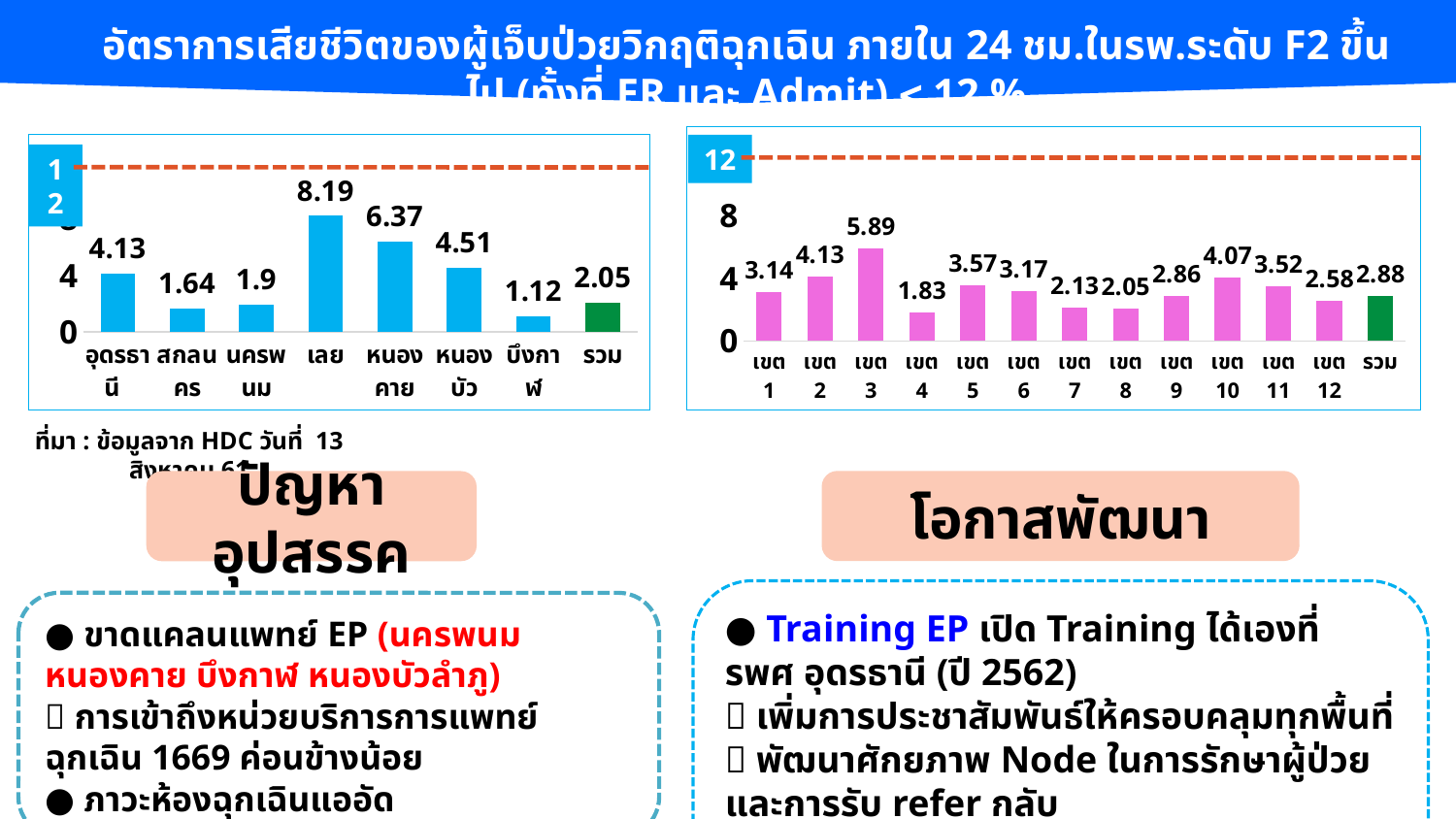
In the right chart, which เขต has the lowest value? เขต 4 In the left chart, what is the difference between the values for เลย and หนองคาย? 1.82 In the right chart, what is the value for เขต 3? 5.89 In the left chart, which category has the lowest value? บึงกาฬ In the right chart, which เขต has the highest value? เขต 3 In the left chart, what is the value for เลย? 8.19 In the right chart, what is the value for รวม? 2.88 In the left chart, what is the value for บึงกาฬ? 1.12 In the right chart, what is the difference between the values for เขต 10 and เขต 8? 2.02 What kind of chart is the right chart? Bar chart In the left chart, which province has the highest value? เลย In the left chart, which is larger, the value for อุดรธานี or the value for หนองบัวลำภู? หนองบัวลำภู